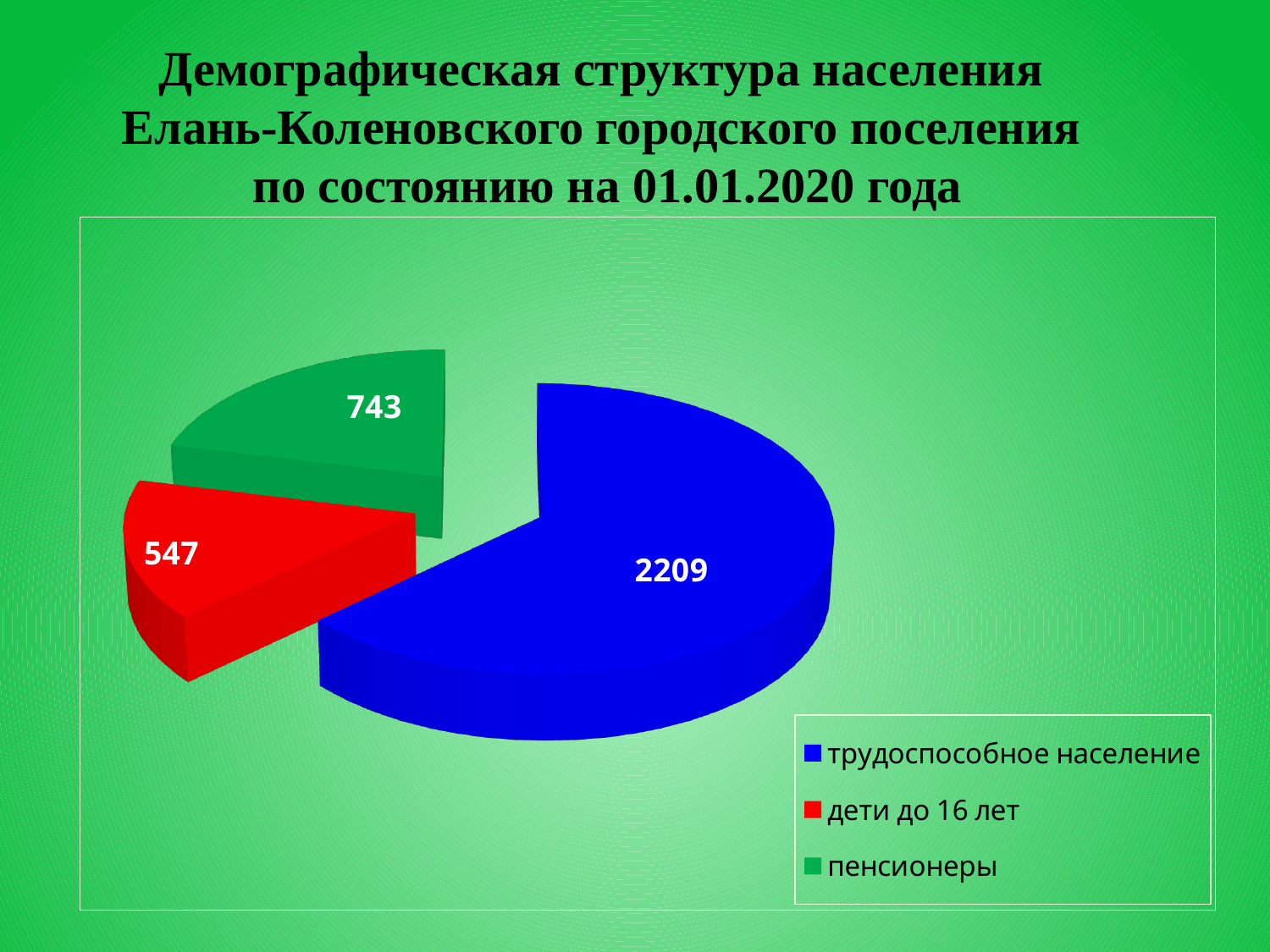
What is the value for трудоспособное население? 2209 What is the value for пенсионеры? 743 What is the difference between the values for трудоспособное население and пенсионеры? 1466 What colour is the slice for пенсионеры? Green What is the difference between the values for пенсионеры and дети до 16 лет? 196 What is the total of all slices in the pie chart? 3499 How many categories does the pie chart have? 3 What is the value for дети до 16 лет? 547 What type of chart is shown on the slide? Pie chart Which category has the smallest slice of the pie? дети до 16 лет Which is larger: пенсионеры or дети до 16 лет? пенсионеры Which category has the largest slice of the pie? трудоспособное население